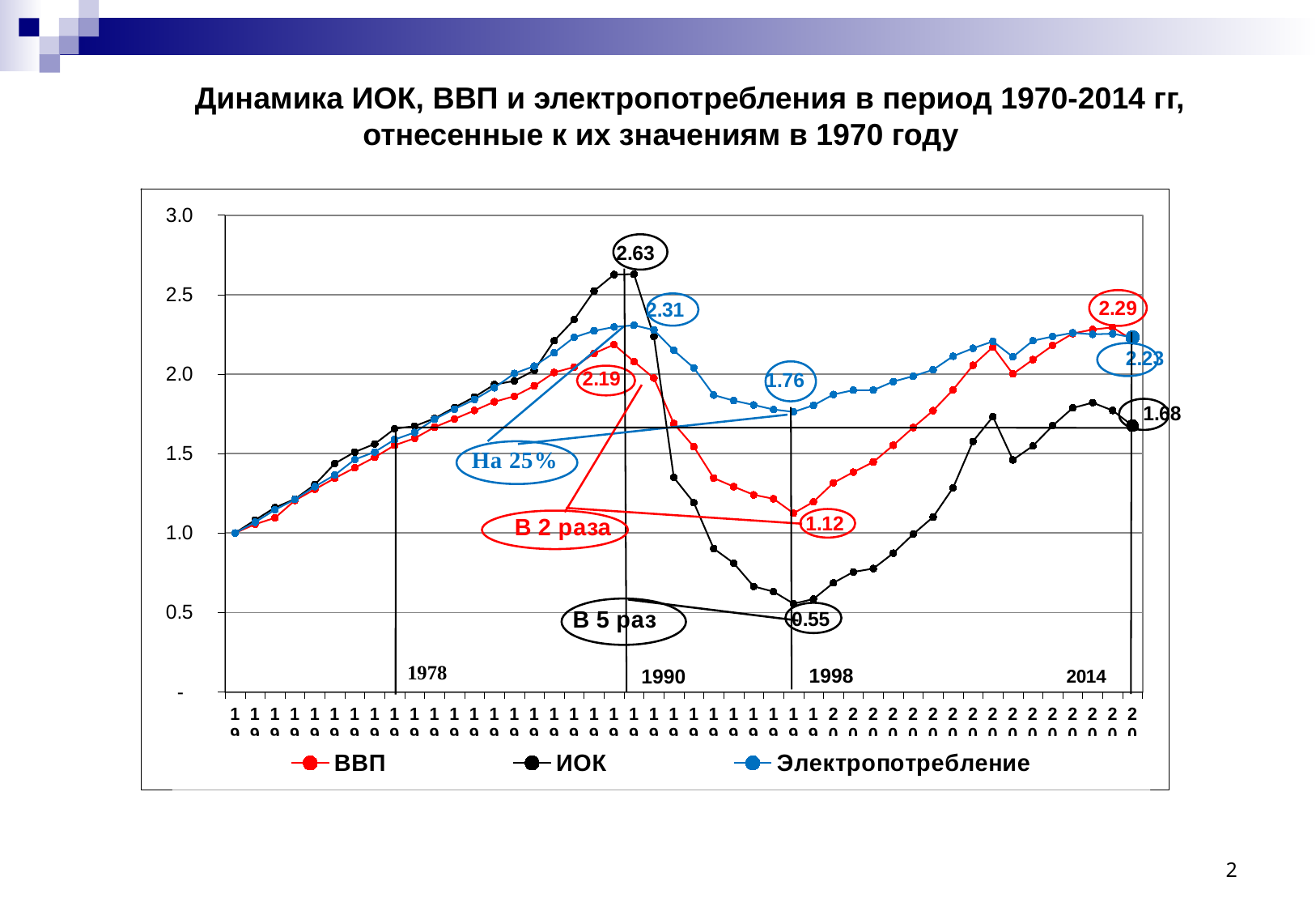
What is the labelled value of ИОК in 2014? 1.68 Which is larger in 2014: the ВВП value or the Электропотребление value? ВВП What kind of chart is shown on the slide? line chart Which series has the lowest labelled value in 1998? ИОК Does the ИОК series rise or fall between 1990 and 1998? fall What is the labelled value of ВВП in 1998? 1.12 What is the labelled value of Электропотребление in 1990? 2.31 Which series has the highest labelled value in 1990? ИОК How many series does the legend list? 3 By how much did the ИОК value fall from 1990 (2.63) to 1998 (0.55)? 2.08 What is the labelled value of ИОК in 1990? 2.63 Is the value for ИОК in 1978 greater or less than 1.5? greater